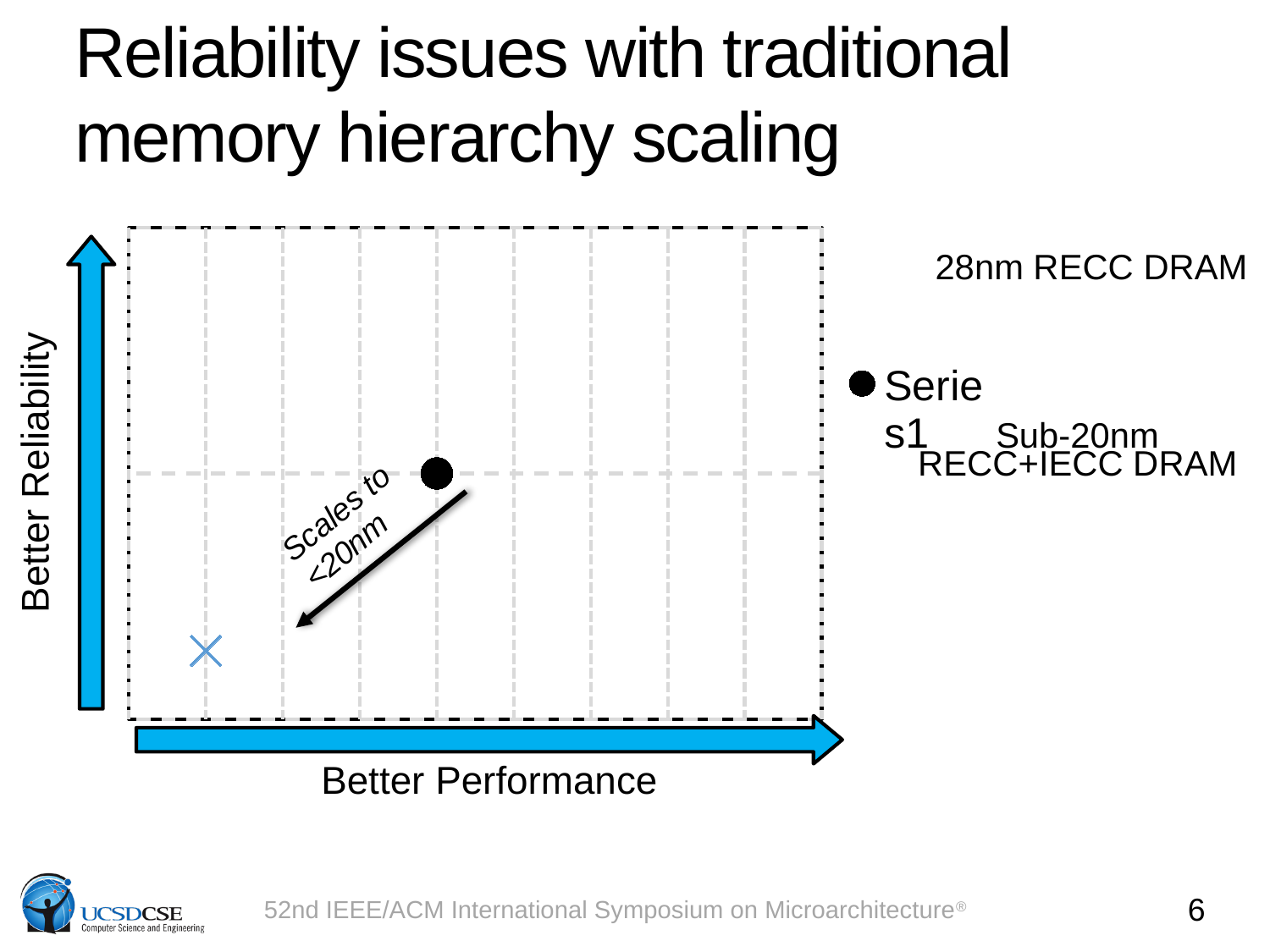
What kind of chart is shown on the slide? scatter chart Does the arrow drawn from the black dot point toward lower or higher reliability? lower Which marker is positioned further right on the horizontal (performance) axis, the black dot or the blue X? the black dot What is the label on the vertical axis of the chart? Better Reliability How many data markers are plotted on the chart? 2 Which marker is positioned higher on the vertical (reliability) axis, the black dot or the blue X? the black dot How many series does the chart legend list? 1 What is the name of the series listed in the chart legend? Series1